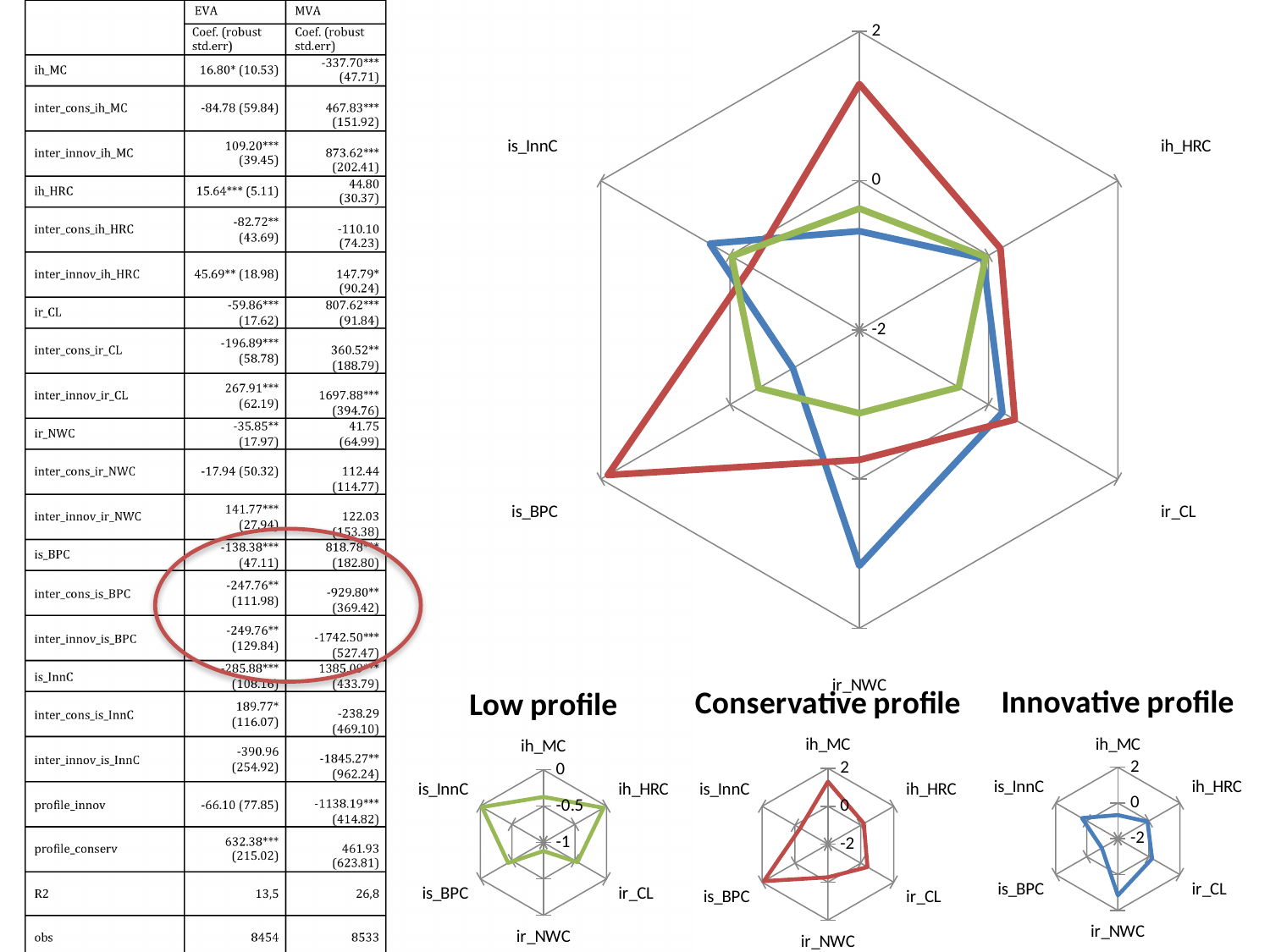
On the large radar chart at the top right, what is the value shown at the outermost ring of the axis? 2 On the 'Conservative profile' radar chart, which category has the highest value? is_BPC On the 'Low profile' radar chart, how many axes (categories) are plotted? 6 On the 'Innovative profile' radar chart, which category has the highest value? ir_NWC On the 'Innovative profile' radar chart, is the value for ir_NWC greater or less than 0? greater On the large radar chart at the top right, what value is shown at the centre of the chart? -2 On the large radar chart at the top right, is the green series' value for ir_CL greater or less than 0? less On the large radar chart at the top right, is the green series' value for is_BPC greater or less than 0? less What kind of chart is the large chart at the top right of the slide? radar chart